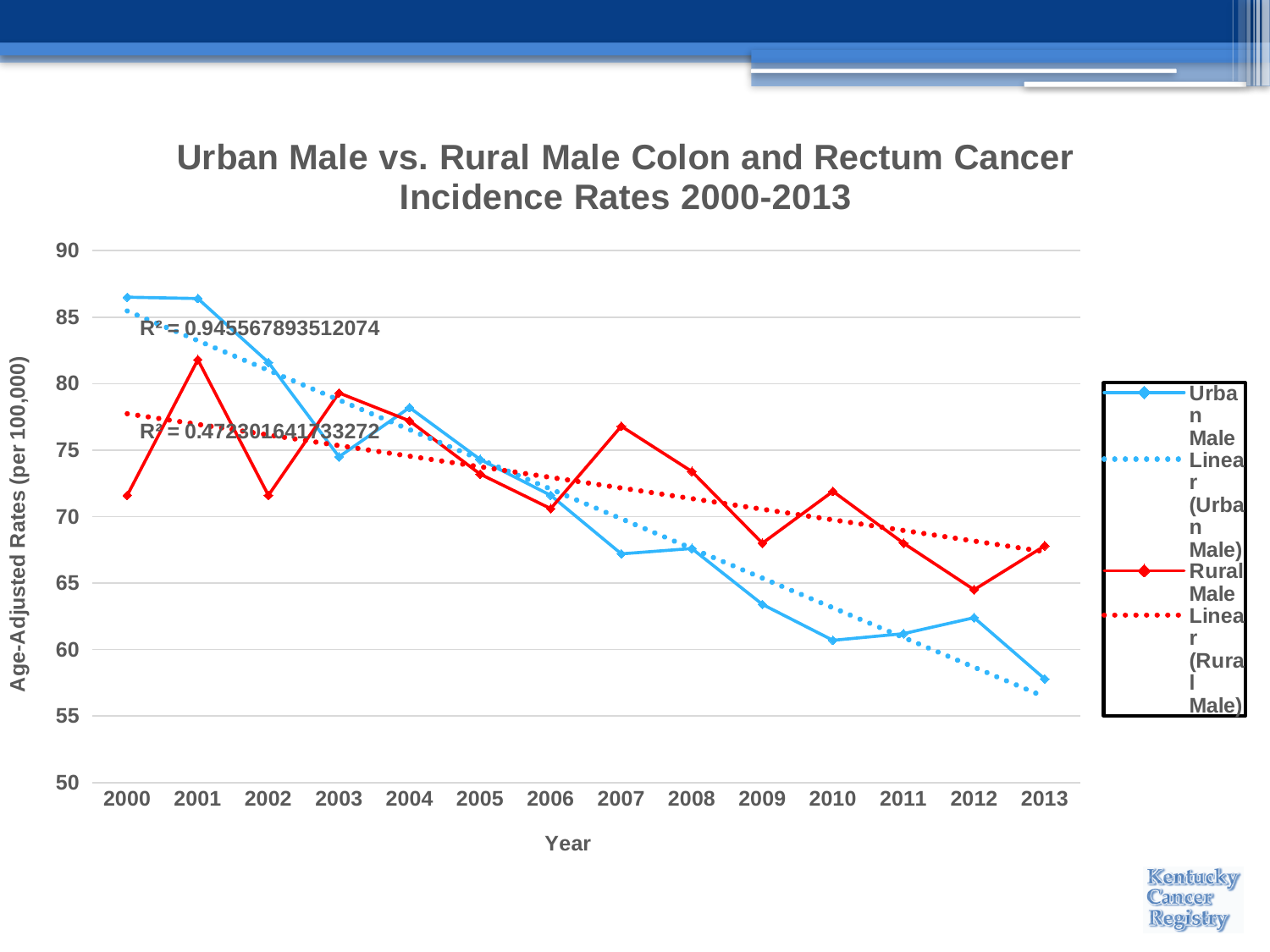
Do the Urban Male incidence rates generally rise or fall from 2000 to 2013? Fall Is the Urban Male value for 2013 greater or less than 60? less Is the Rural Male value for 2000 greater or less than 75? less What is the R² value shown for the Urban Male linear trendline? 0.945567893512074 In which year is the Rural Male incidence rate highest? 2001 In which year is the Urban Male incidence rate lowest? 2013 What kind of chart is shown on the slide? Line chart In 2013, which series has the higher incidence rate, Urban Male or Rural Male? Rural Male Is the Urban Male value for 2000 greater or less than 85? greater In which year is the Rural Male incidence rate lowest? 2012 How many entries does the legend list? 4 How many years are plotted along the x axis? 14